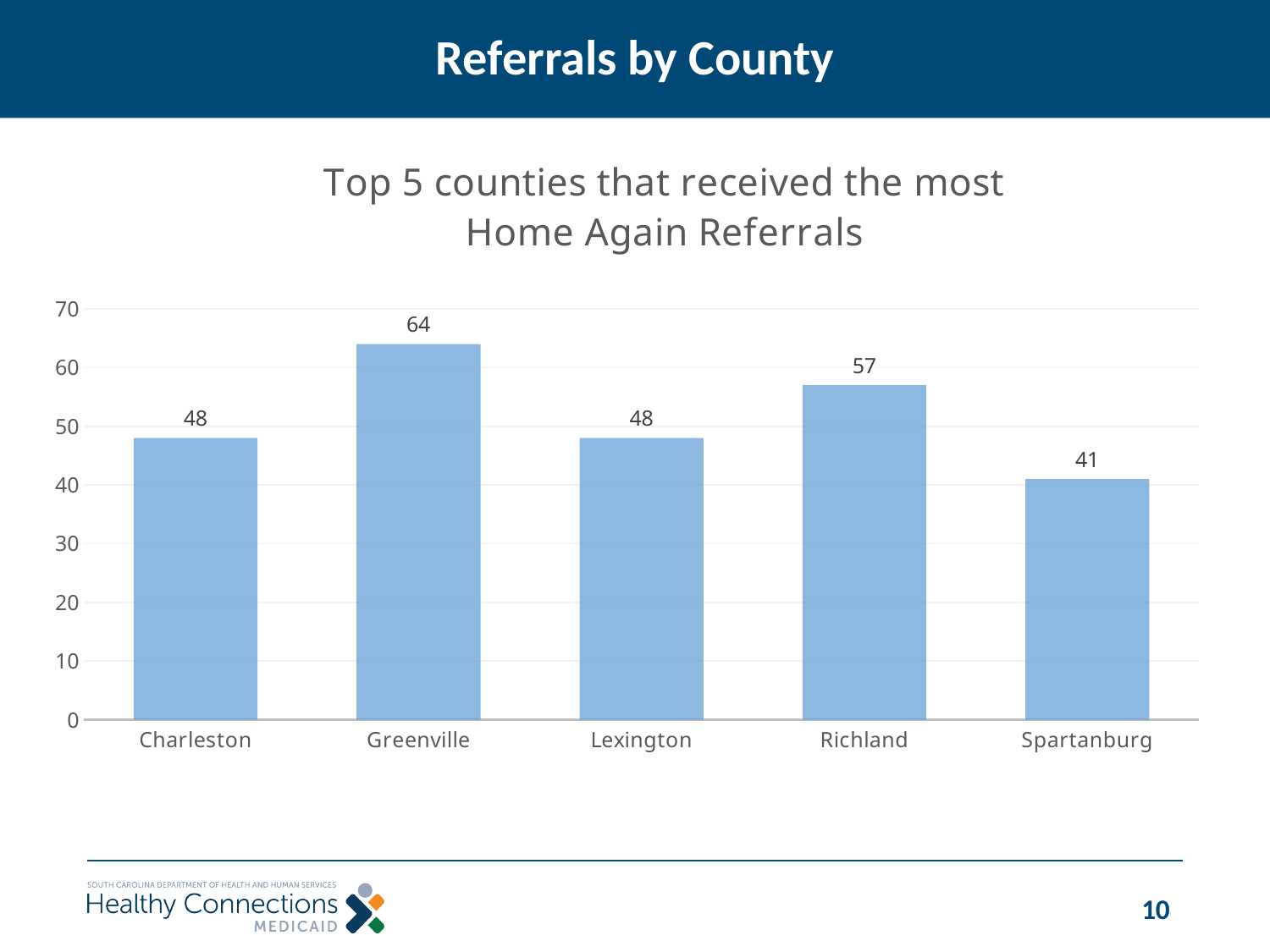
What is the value for Spartanburg? 41 Is the value for Richland greater or less than 50? greater What is the title of the chart? Top 5 counties that received the most Home Again Referrals What is the difference between the values for Charleston and Spartanburg? 7 What is the value for Richland? 57 Which county has the highest value? Greenville What is the value for Greenville? 64 What kind of chart is shown on the slide? bar chart Which is larger, the value for Richland or the value for Lexington? Richland What is the difference between the values for Greenville and Richland? 7 Which county has the lowest value? Spartanburg How many counties are shown in the chart? 5